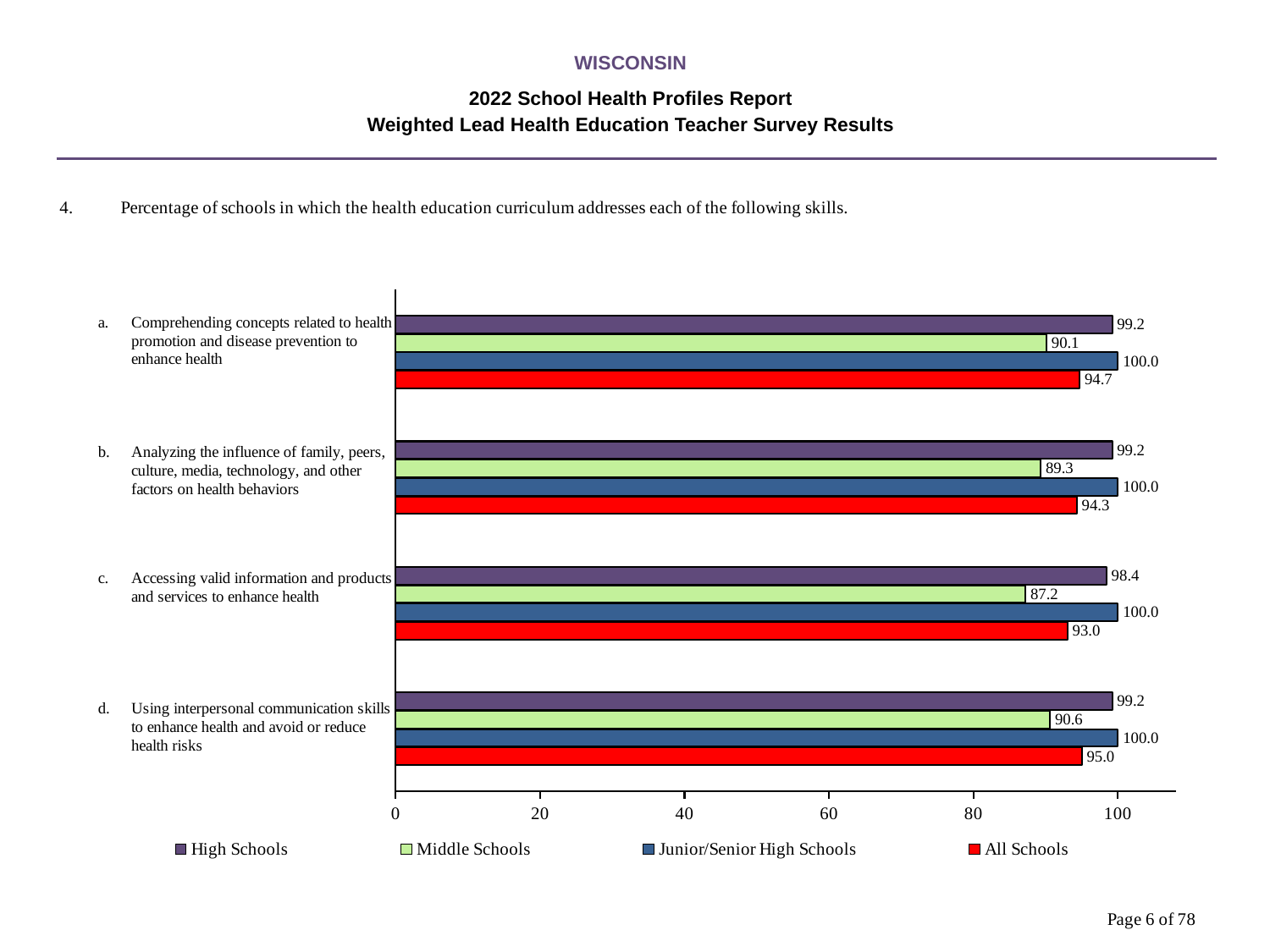
Which skill has the lowest Middle Schools value? c. Accessing valid information and products and services to enhance health Which colour represents All Schools in the legend? Red How many series does the legend list? 4 What kind of chart is shown on the slide? Bar chart What is the difference between the High Schools and Middle Schools values for skill b, analyzing the influence of family, peers, culture, media, technology, and other factors on health behaviors? 9.9 What is the value for Junior/Senior High Schools for skill d, using interpersonal communication skills to enhance health and avoid or reduce health risks? 100.0 Which is larger for skill d: the Middle Schools value or the All Schools value? All Schools How many skills (categories) are shown on the chart? 4 What is the value for Middle Schools for skill a, comprehending concepts related to health promotion and disease prevention to enhance health? 90.1 Which skill has the highest All Schools value? d. Using interpersonal communication skills to enhance health and avoid or reduce health risks What is the value for All Schools for skill c, accessing valid information and products and services to enhance health? 93.0 What is the value for High Schools for skill c, accessing valid information and products and services to enhance health? 98.4